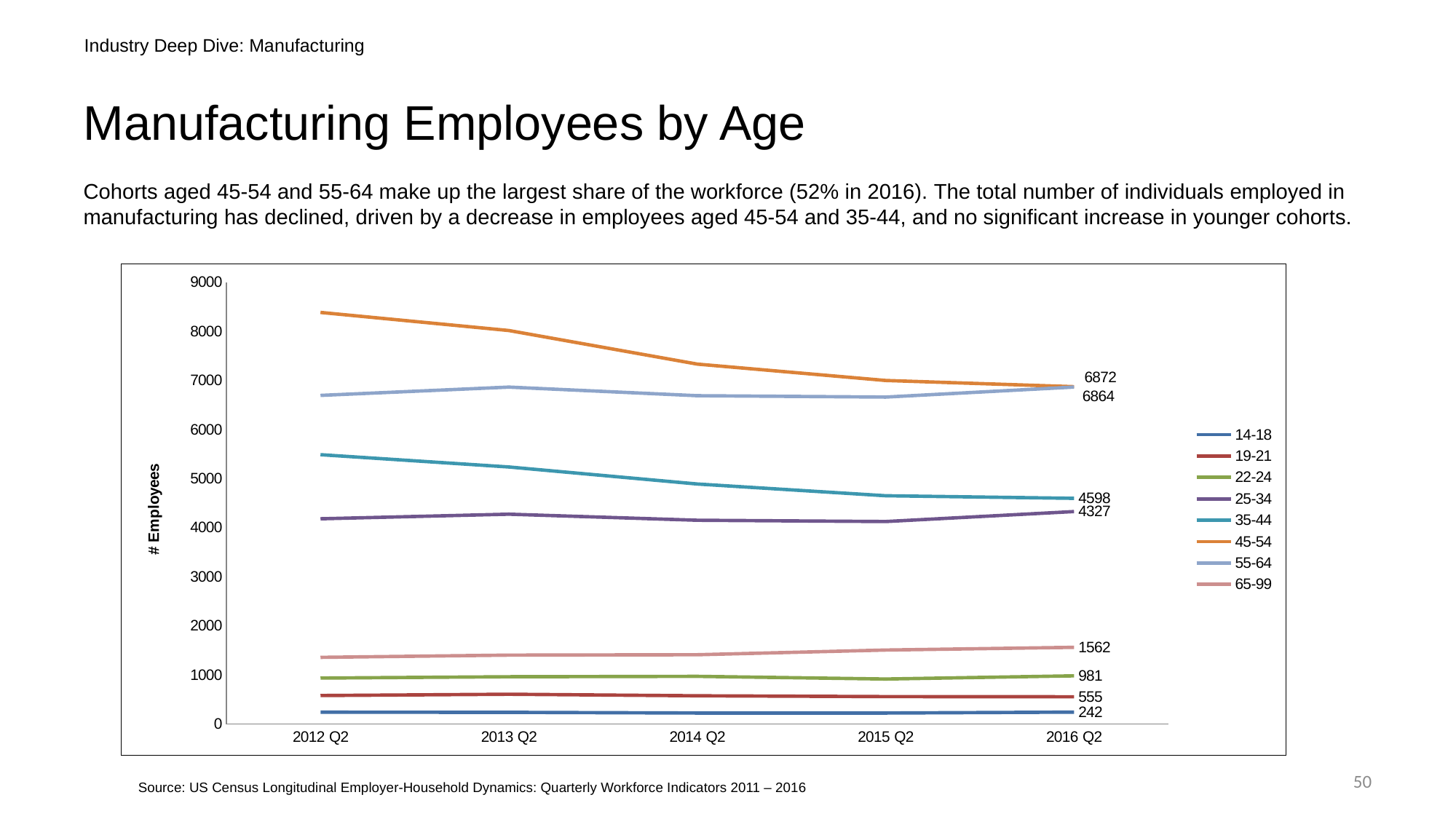
At 2016 Q2, which is larger: the value for 22-24 or the value for 19-21? 22-24 What is the value for the 45-54 cohort at 2016 Q2? 6872 What is the value for the 35-44 cohort at 2016 Q2? 4598 Is the value for the 45-54 cohort at 2012 Q2 greater or less than 8000? greater Does the value for the 45-54 cohort rise or fall from 2012 Q2 to 2016 Q2? fall Which age cohort has the highest value at 2012 Q2? 45-54 What is the value for the 65-99 cohort at 2016 Q2? 1562 What is the value for the 14-18 cohort at 2016 Q2? 242 Which age cohort has the lowest value at 2016 Q2? 14-18 How many time points are shown on the x axis? 5 What is the difference between the 35-44 and 25-34 values at 2016 Q2? 271 How many series does the legend list? 8